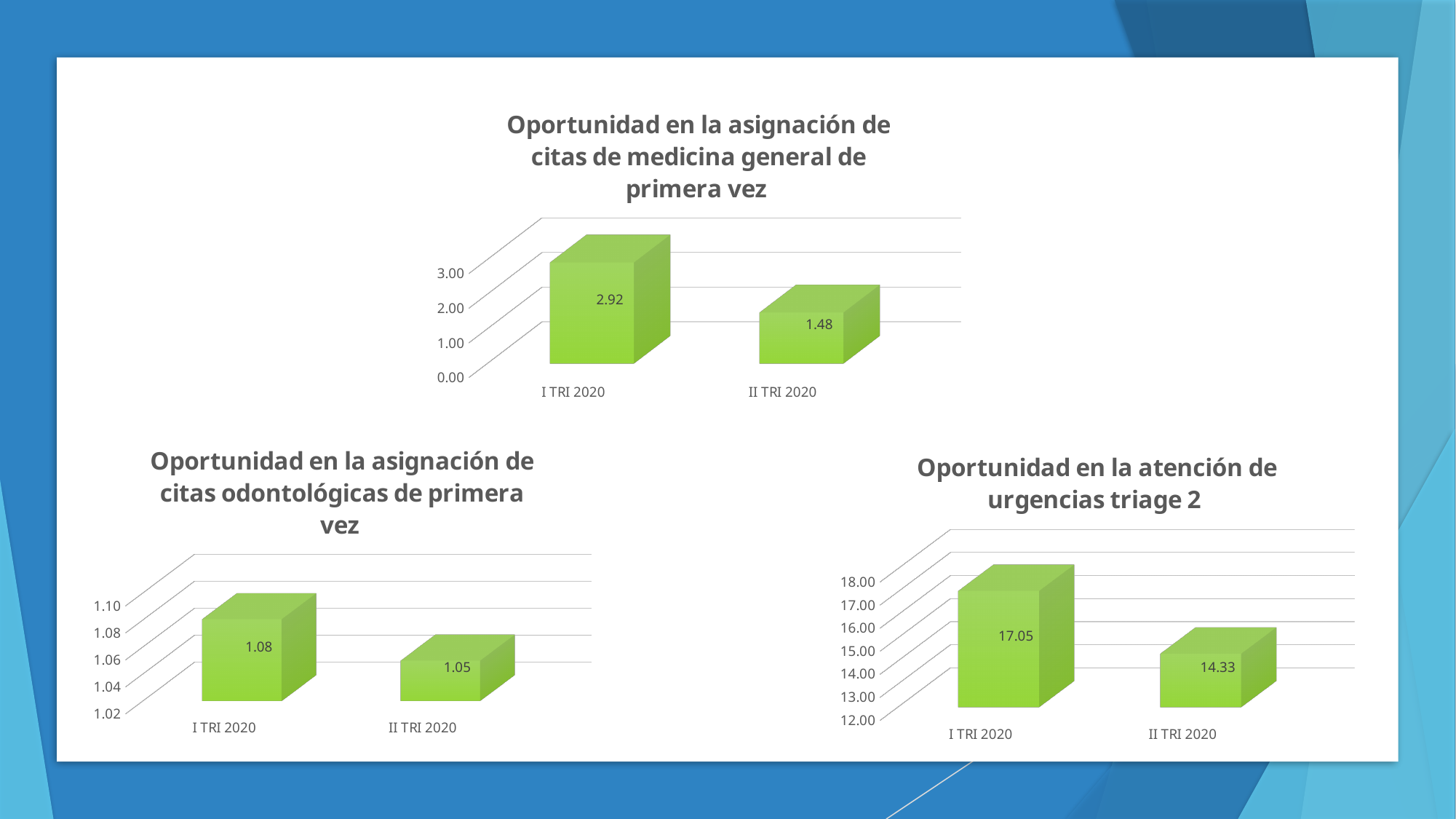
In the chart titled 'Oportunidad en la asignación de citas odontológicas de primera vez', which category has the lowest value? II TRI 2020 In the chart titled 'Oportunidad en la atención de urgencias triage 2', what is the value for II TRI 2020? 14.33 In the chart titled 'Oportunidad en la asignación de citas odontológicas de primera vez', what is the value for II TRI 2020? 1.05 How many categories are shown in the chart titled 'Oportunidad en la asignación de citas de medicina general de primera vez'? 2 In the chart titled 'Oportunidad en la atención de urgencias triage 2', do the values rise or fall from I TRI 2020 to II TRI 2020? fall In the chart titled 'Oportunidad en la asignación de citas odontológicas de primera vez', what is the value for I TRI 2020? 1.08 In the chart titled 'Oportunidad en la asignación de citas de medicina general de primera vez', what is the value for I TRI 2020? 2.92 In the chart titled 'Oportunidad en la asignación de citas de medicina general de primera vez', what is the difference between the I TRI 2020 and II TRI 2020 values? 1.44 In the chart titled 'Oportunidad en la atención de urgencias triage 2', what is the value for I TRI 2020? 17.05 In the chart titled 'Oportunidad en la atención de urgencias triage 2', what is the difference between the I TRI 2020 and II TRI 2020 values? 2.72 In the chart titled 'Oportunidad en la asignación de citas de medicina general de primera vez', what is the value for II TRI 2020? 1.48 In the chart titled 'Oportunidad en la atención de urgencias triage 2', which category has the highest value? I TRI 2020